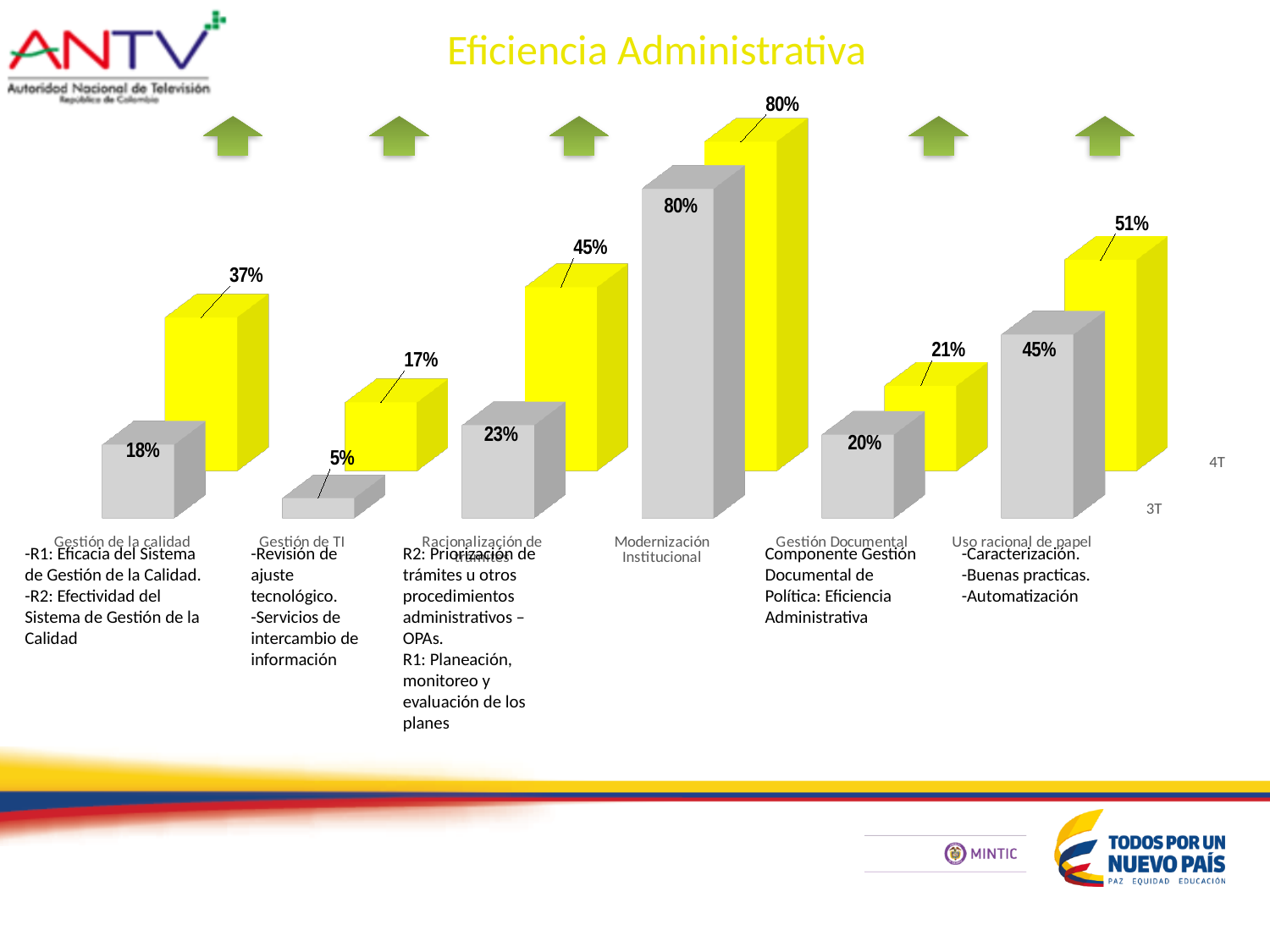
How many series (3T and 4T) does the chart show? 2 What is the title of the chart? Eficiencia Administrativa Which is larger, the 4T value for Gestión de TI or the 4T value for Gestión Documental? Gestión Documental What is the 3T value for Gestión de TI? 5% How many categories are shown on the chart? 6 What is the 4T value for Gestión de la calidad? 37% What is the 3T value for Racionalización de trámites? 23% What is the difference between the 4T and 3T values for Gestión de la calidad? 19% What is the 4T value for Uso racional de papel? 51% Which category has the lowest 3T value? Gestión de TI What is the difference between the 4T and 3T values for Racionalización de trámites? 22% Which category has the highest 4T value? Modernización Institucional